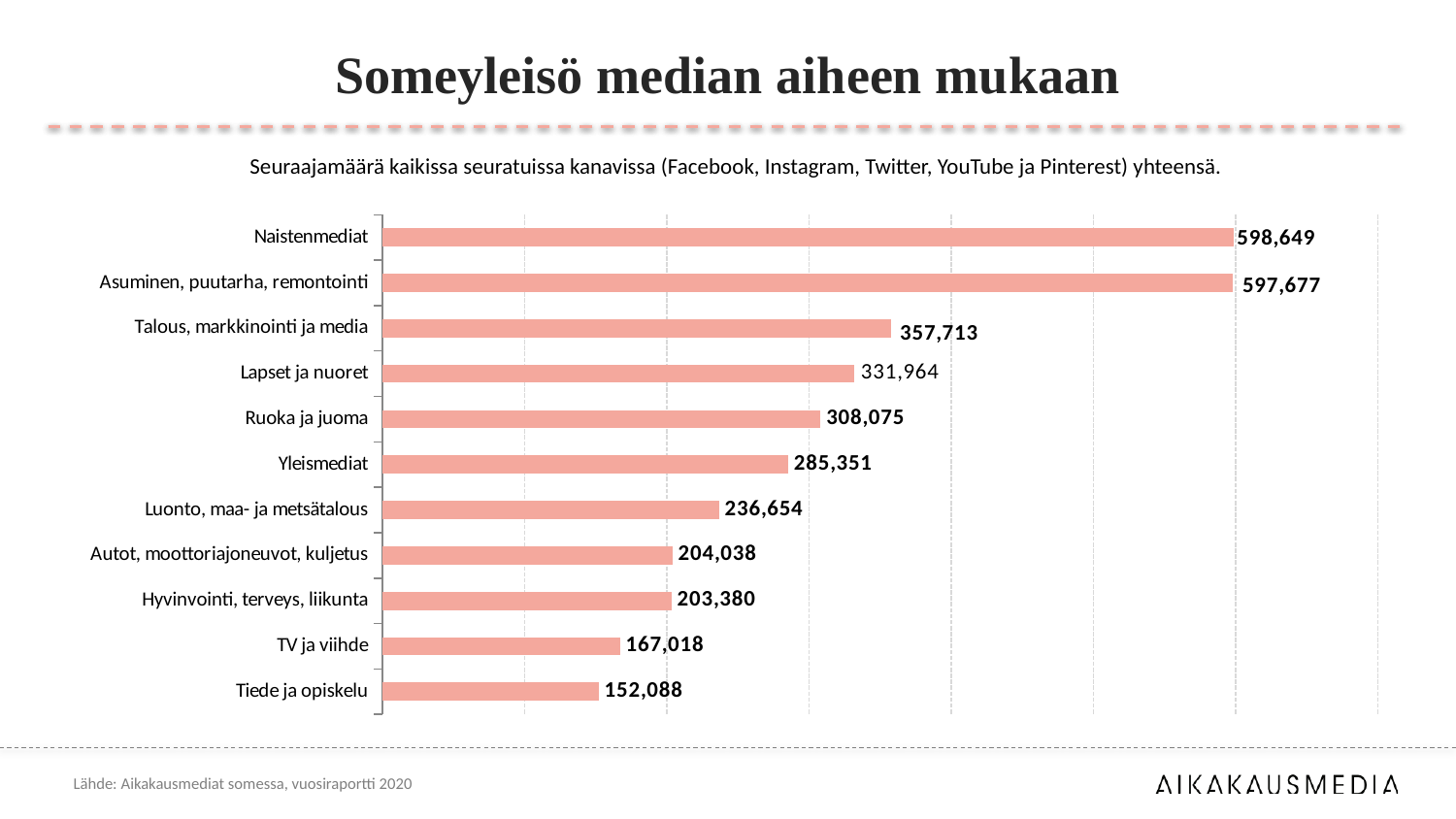
What is the value for Tiede ja opiskelu? 152,088 How many categories are shown in the chart? 11 What is the difference between the values for TV ja viihde and Tiede ja opiskelu? 14,930 Which category has the highest value? Naistenmediat Which is larger, the value for Autot, moottoriajoneuvot, kuljetus or the value for Hyvinvointi, terveys, liikunta? Autot, moottoriajoneuvot, kuljetus What is the difference between the values for Talous, markkinointi ja media and Lapset ja nuoret? 25,749 What is the value for Yleismediat? 285,351 What is the value for Ruoka ja juoma? 308,075 What is the title of the slide? Someyleisö median aiheen mukaan Which category has the lowest value? Tiede ja opiskelu What is the value for Luonto, maa- ja metsätalous? 236,654 What kind of chart is shown on the slide? Bar chart